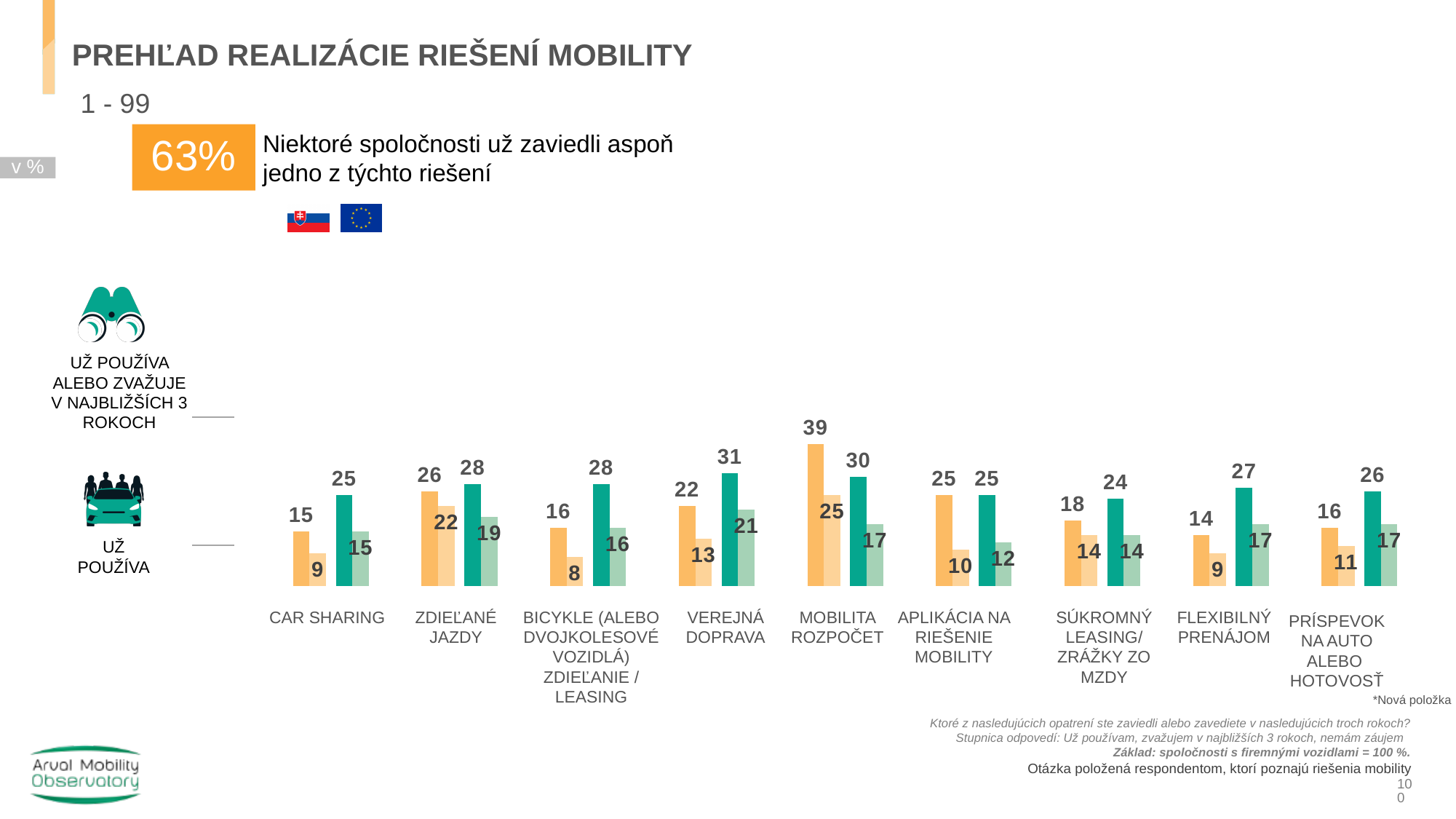
For ZDIEĽANÉ JAZDY, which is larger for 'už používa alebo zvažuje': the Slovak (orange) value or the EU (green) value? EU (green), 28 What percentage is shown in the orange box at the top of the slide? 63% For CAR SHARING, what is the difference between the EU (green) and Slovak (orange) 'už používa alebo zvažuje' values? 10 What is the Slovak (orange) value for 'už používa alebo zvažuje v najbližších 3 rokoch' for MOBILITA ROZPOČET? 39 How many mobility solution categories are shown on the x axis of the chart? 9 Which category has the highest Slovak (orange) 'už používa alebo zvažuje' value? MOBILITA ROZPOČET What is the EU (light green) 'už používa' value for VEREJNÁ DOPRAVA? 21 Which category has the lowest Slovak (light orange) 'už používa' value? BICYKLE (ALEBO DVOJKOLESOVÉ VOZIDLÁ) ZDIEĽANIE / LEASING What is the Slovak (light orange) 'už používa' value for ZDIEĽANÉ JAZDY? 22 Which category has the highest EU (dark green) 'už používa alebo zvažuje' value? VEREJNÁ DOPRAVA For MOBILITA ROZPOČET, what is the difference between the Slovak 'už používa alebo zvažuje' value and the Slovak 'už používa' value? 14 What kind of chart is shown on the slide? Bar chart